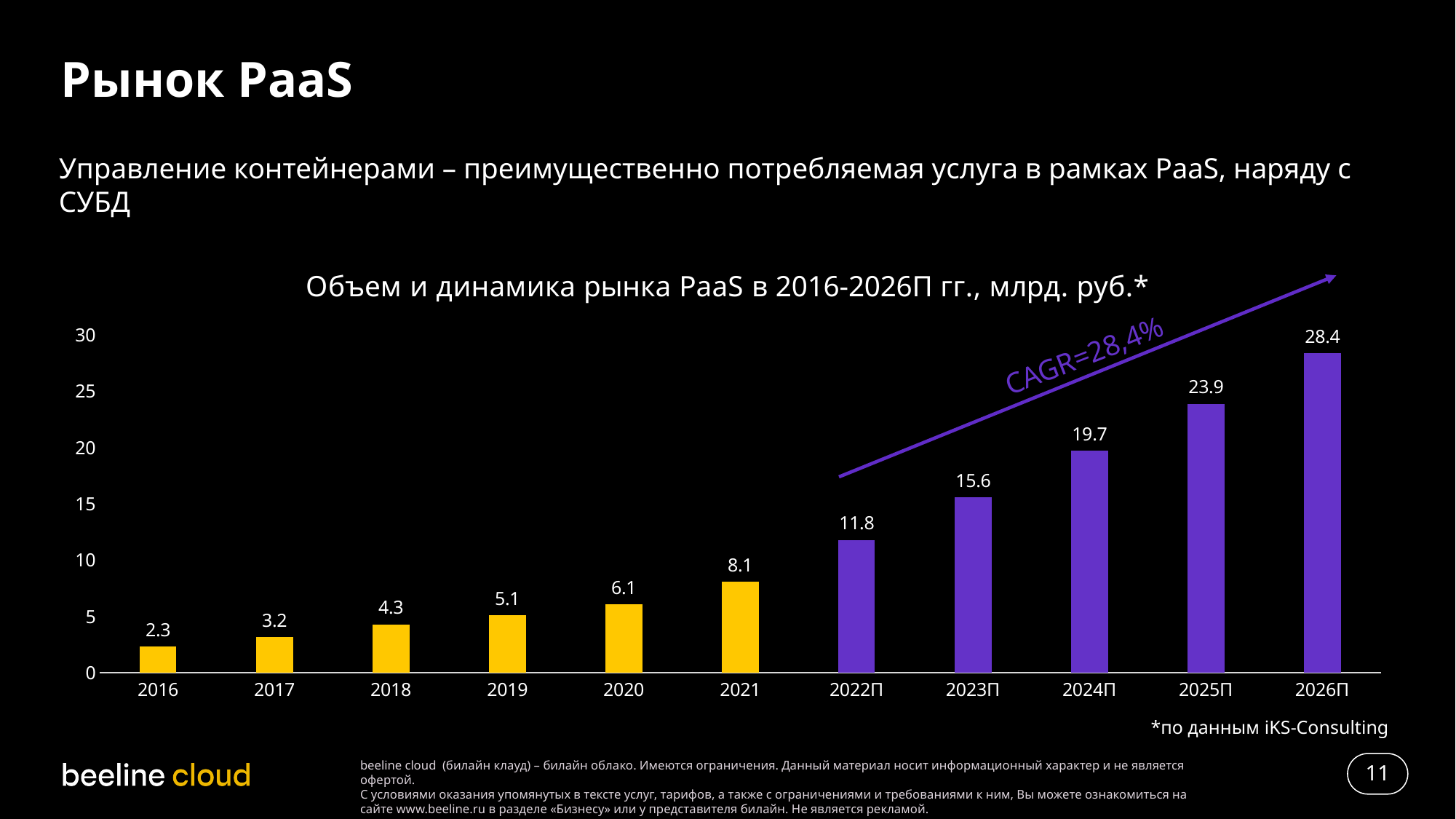
What is the difference between the values for 2021 and 2020? 2.0 What is the difference between the values for 2026П and 2025П? 4.5 What kind of chart is this? bar chart What is the value for 2016? 2.3 Which year has the lowest value? 2016 Which year has the highest value? 2026П What CAGR is shown on the chart? 28,4% What is the value for 2024П? 19.7 Do the values rise or fall from 2016 to 2026П? rise How many years are shown on the x axis? 11 Which is larger, the value for 2022П or the value for 2021? 2022П What is the value for 2019? 5.1